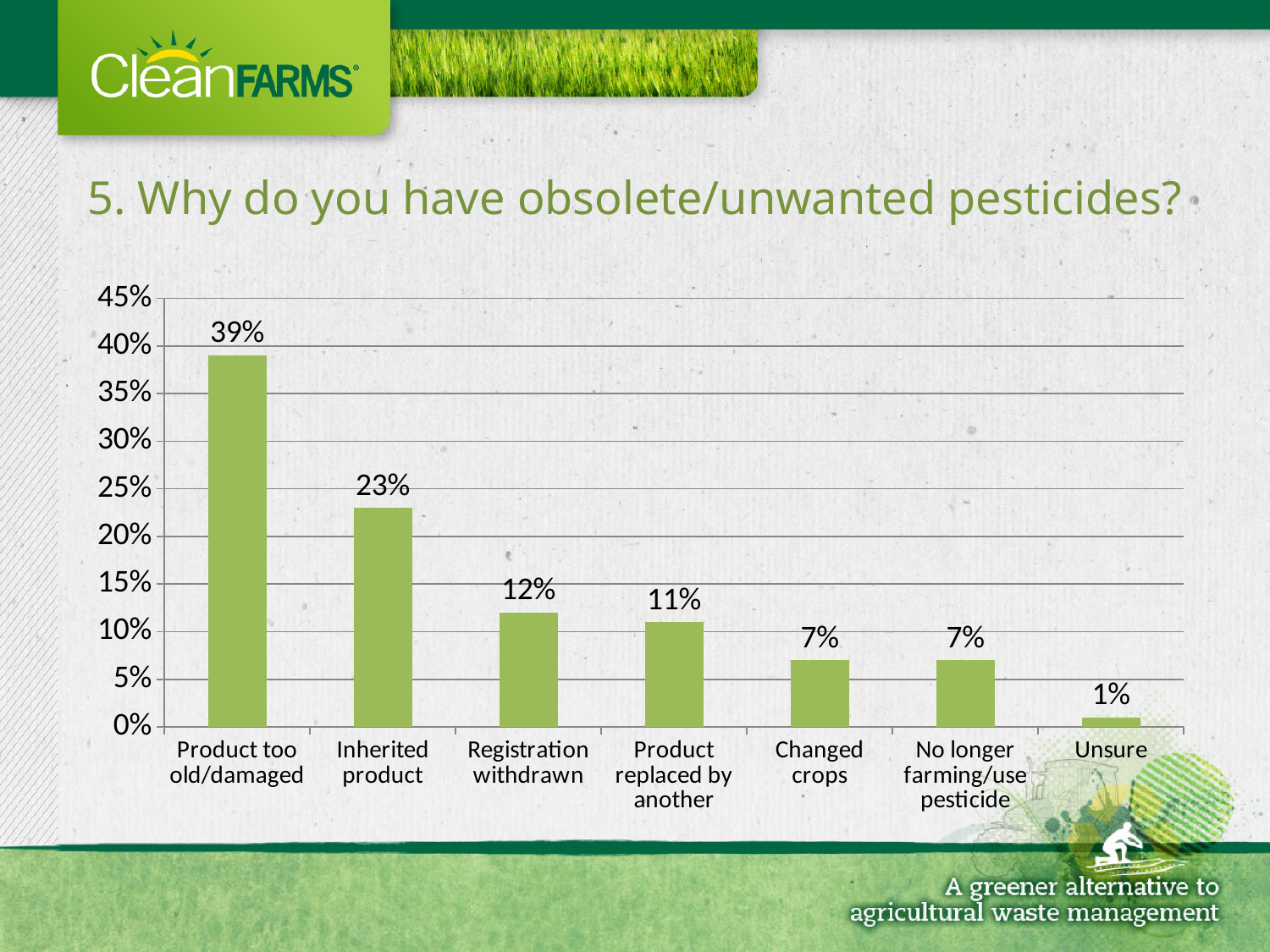
What is the difference in percentage points between "Product too old/damaged" and "Inherited product"? 16 Do the values generally rise or fall from left to right along the x axis? Fall What is the value shown for "Inherited product"? 23% What is the value for "Product replaced by another"? 11% Which is larger, the value for "Registration withdrawn" or the value for "Changed crops"? Registration withdrawn What kind of chart is shown on the slide? Bar chart How many reason categories are shown on the x axis? 7 What percentage of respondents cited "Product too old/damaged" as the reason for having obsolete/unwanted pesticides? 39% Which reason has the lowest percentage? Unsure Which reason has the highest percentage? Product too old/damaged What percentage is shown for "Registration withdrawn"? 12% What percentage is shown for "Unsure"? 1%